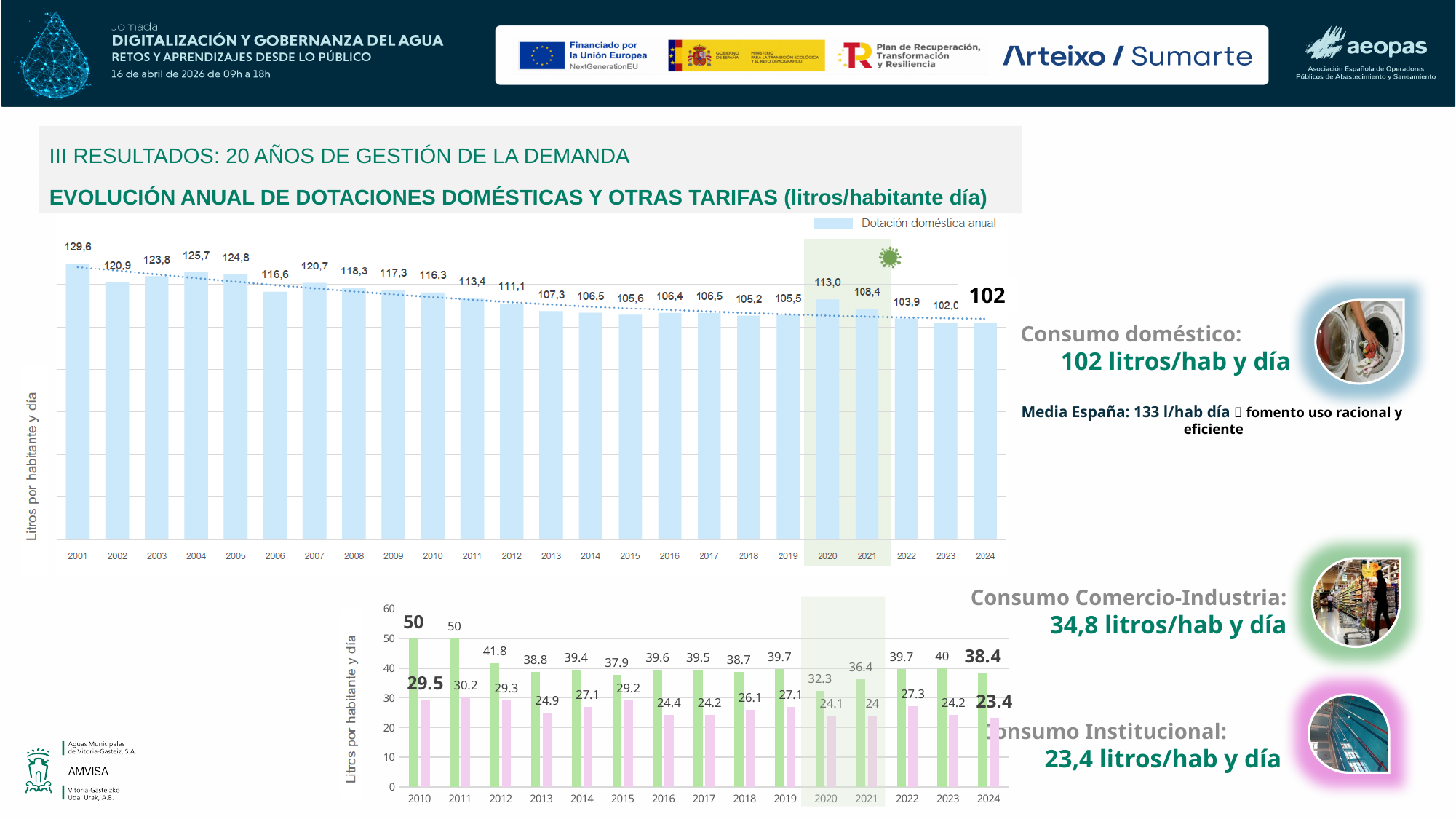
In the top chart (Dotación doméstica anual), which year has the highest value? 2001 In the top chart (Dotación doméstica anual), what is the value for 2001? 129,6 What is the legend entry shown for the top chart? Dotación doméstica anual In the bottom chart, what is the value of the pink bar for 2024? 23.4 In the top chart (Dotación doméstica anual), which year has the larger value, 2020 or 2021? 2020 In the top chart (Dotación doméstica anual), how many years are plotted? 24 In the bottom chart, what is the value of the green bar for 2010? 50 In the top chart (Dotación doméstica anual), what is the difference between the 2001 value and the 2024 value? 27,6 In the top chart (Dotación doméstica anual), what is the value for 2020? 113,0 In the bottom chart, which year has the lowest green bar? 2020 In the bottom chart, how many years are plotted on the x axis? 15 In the top chart (Dotación doméstica anual), do the values generally rise or fall from 2001 to 2024? fall